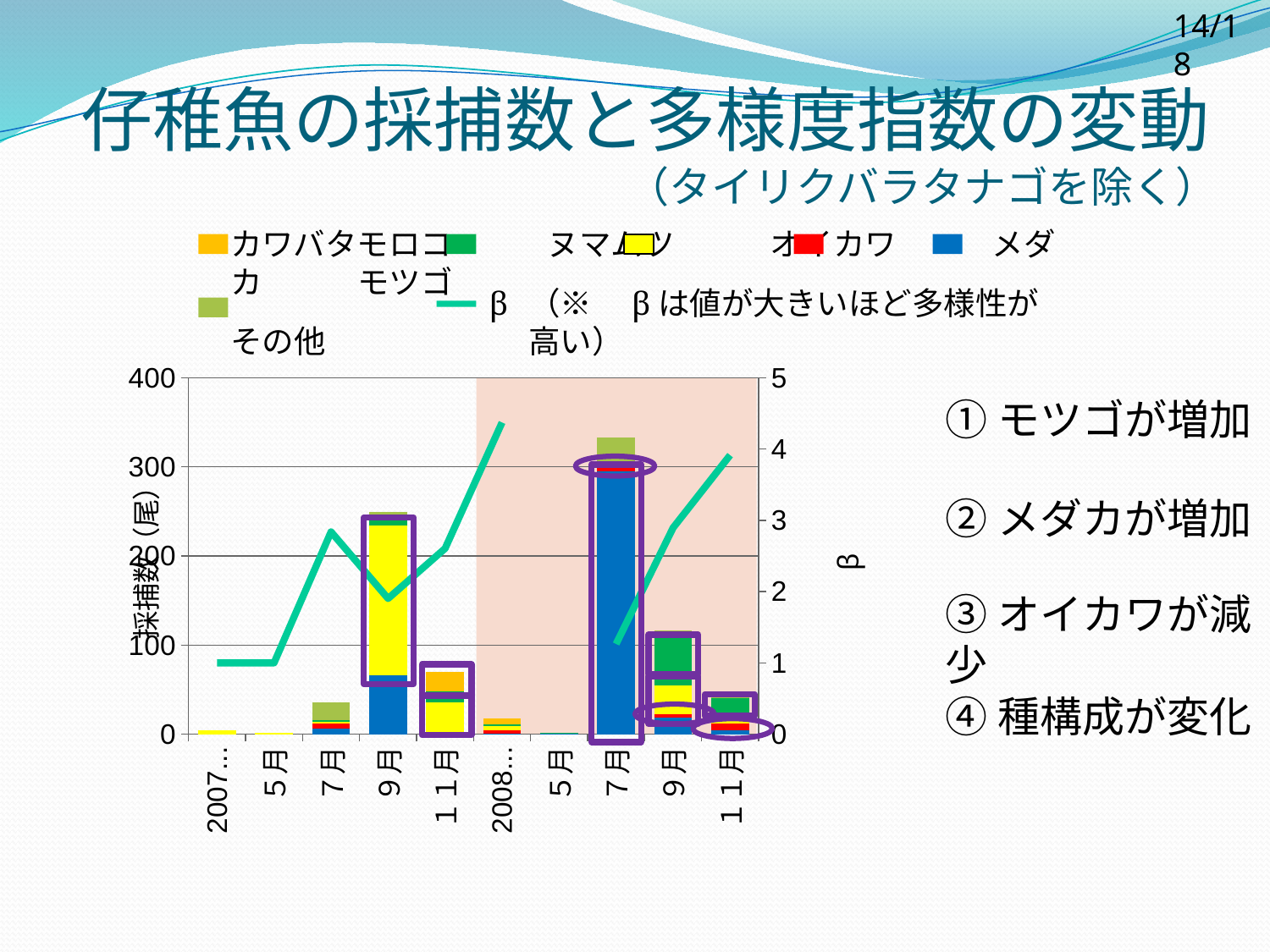
What kind of chart is shown on the slide? bar chart with a line Is the total stacked bar for 2007 11月 greater or less than 100? less What is the label of the right-hand vertical axis? β Is the total stacked bar for 2008 7月 greater or less than 300? greater How many series does the chart's legend list? 7 Is the β value at 2008... greater or less than 4? greater Does the β line rise or fall from 2008 7月 to 2008 11月? rise Which category has the tallest stacked bar? 2008 7月 Which stacked bar is taller, 2007 9月 or 2008 7月? 2008 7月 How many categories are shown along the x axis of the chart? 10